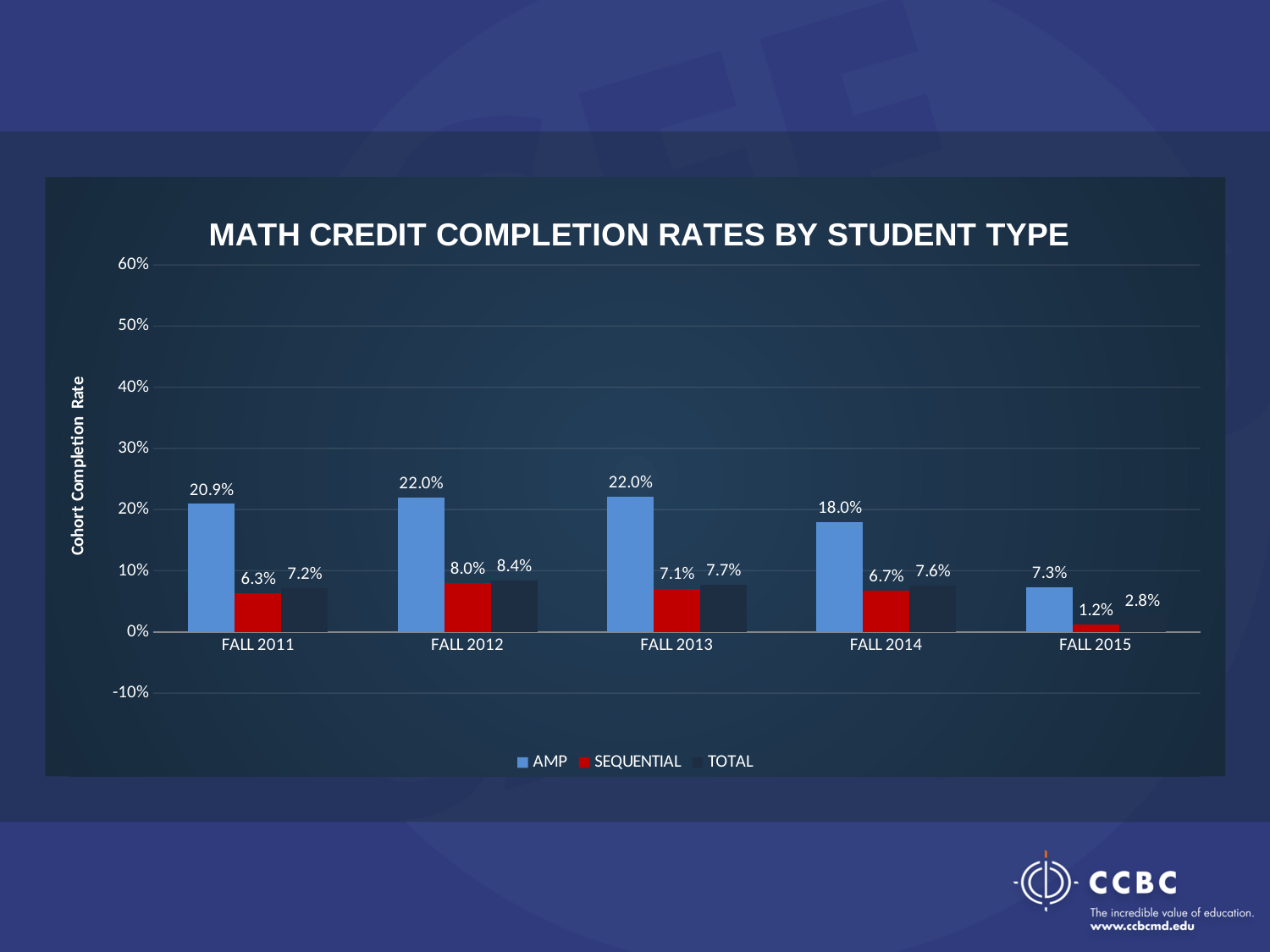
What is the SEQUENTIAL value for FALL 2014? 6.7% What is the TOTAL value for FALL 2015? 2.8% Which year has the lowest AMP value? FALL 2015 Which is larger, the TOTAL value for FALL 2012 or the TOTAL value for FALL 2014? FALL 2012 Is the AMP value for FALL 2014 greater or less than 10%? greater How many years are shown on the x axis? 5 How many series does the legend list? 3 What is the title of the chart? MATH CREDIT COMPLETION RATES BY STUDENT TYPE What kind of chart is shown? bar chart Which year has the highest SEQUENTIAL value? FALL 2012 What is the difference between the AMP and SEQUENTIAL values for FALL 2013? 14.9% What is the AMP value for FALL 2011? 20.9%